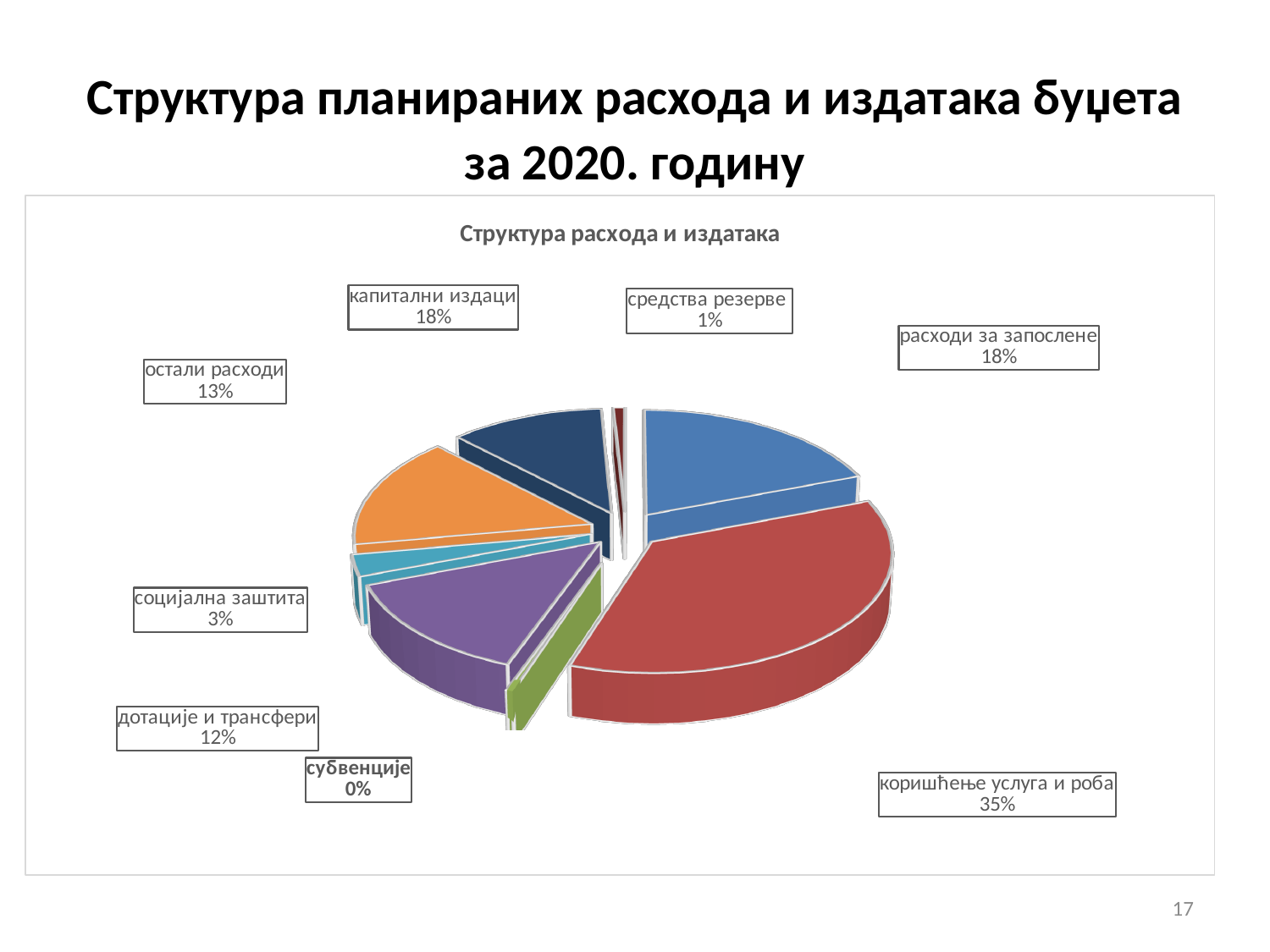
What share of the pie does дотације и трансфери have? 12% Which category has the largest share of the pie? коришћење услуга и роба What share of the pie does остали расходи have? 13% What is the difference in percentage points between коришћење услуга и роба and капитални издаци? 17 What share of the pie does социјална заштита have? 3% What is the title of the chart? Структура расхода и издатака Which category has the smallest share of the pie? субвенције How many categories (slices) are shown in the pie chart? 8 What kind of chart is shown on the slide? pie chart